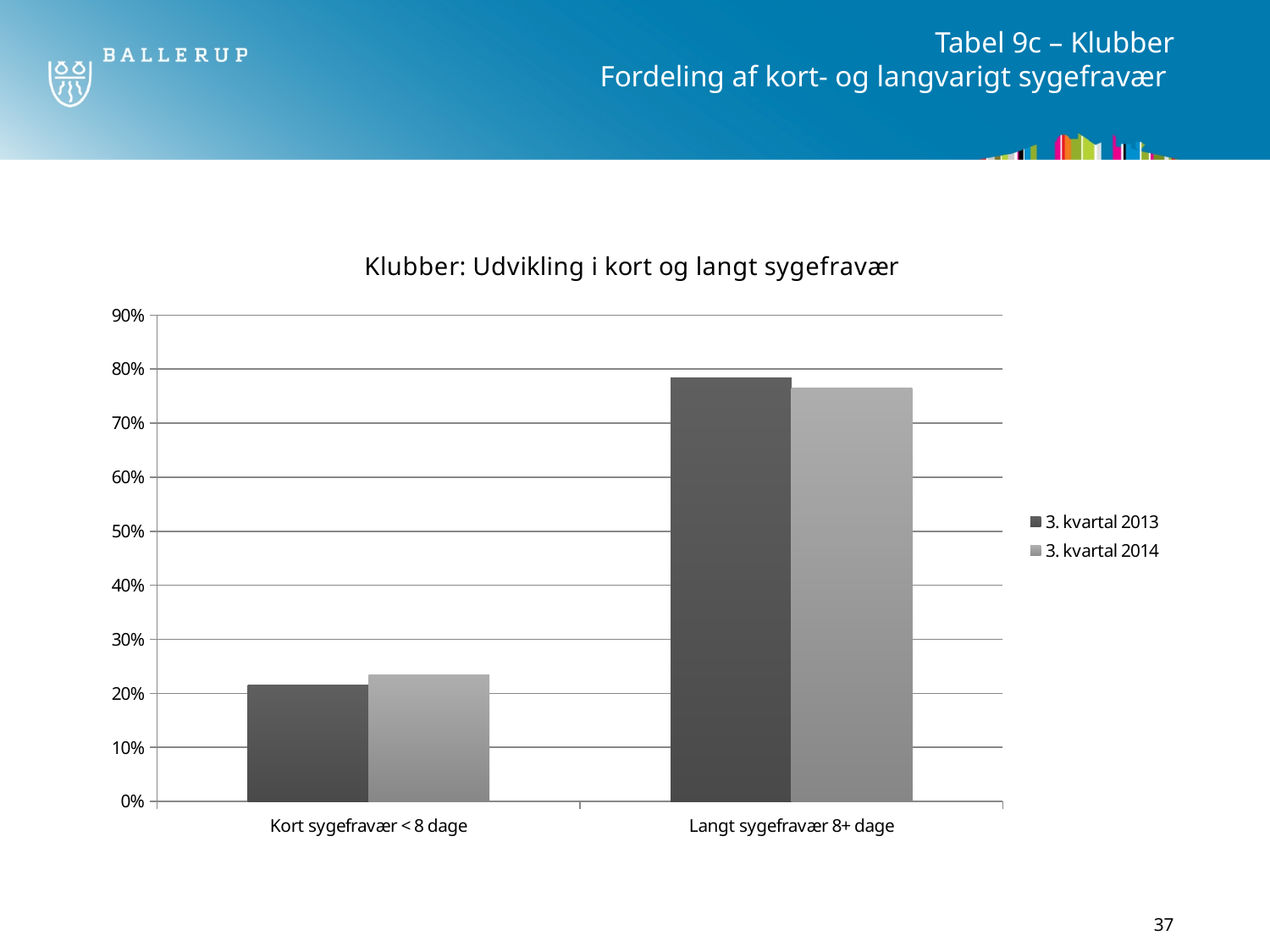
Which series does the legend list first? 3. kvartal 2013 Is the value for Langt sygefravær 8+ dage in 3. kvartal 2013 greater or less than 70%? greater For Langt sygefravær 8+ dage, which series has the larger value: 3. kvartal 2013 or 3. kvartal 2014? 3. kvartal 2013 How many series does the legend list? 2 Is the value for Langt sygefravær 8+ dage in 3. kvartal 2014 greater or less than 80%? less Which category has the lowest value in 3. kvartal 2013? Kort sygefravær < 8 dage How many categories are shown on the x axis? 2 Is the value for Kort sygefravær < 8 dage in 3. kvartal 2013 greater or less than 30%? less What is the title of the chart? Klubber: Udvikling i kort og langt sygefravær What kind of chart is shown on the slide? bar chart Which category has the higher value in 3. kvartal 2014: Kort sygefravær < 8 dage or Langt sygefravær 8+ dage? Langt sygefravær 8+ dage